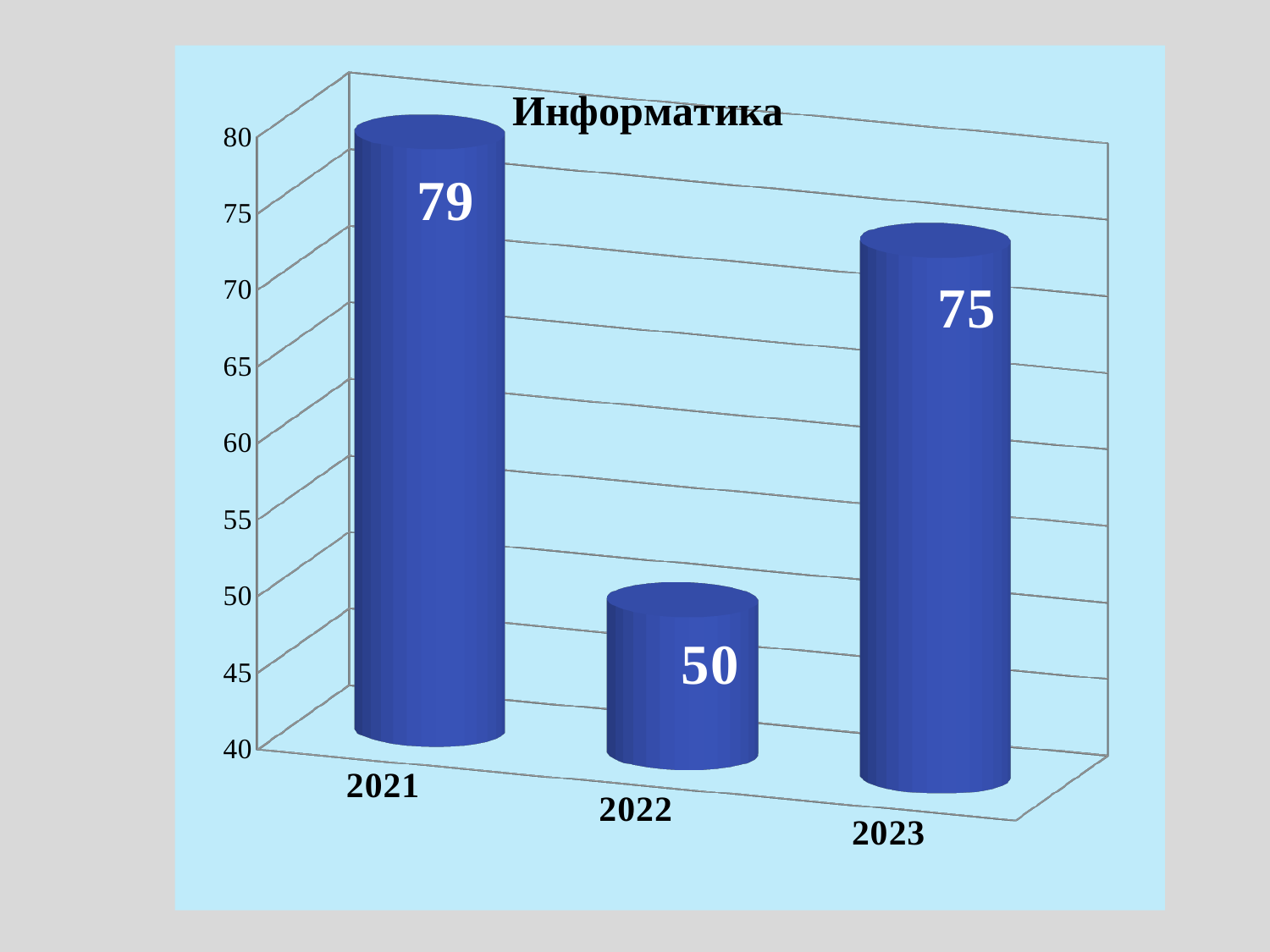
What is the title of the chart? Информатика Is the value for 2022 greater or less than 60? less What kind of chart is shown on the slide? bar chart What is the value for 2023? 75 What is the difference between the values for 2021 and 2022? 29 Which year has the lowest value? 2022 What is the value for 2021? 79 Which year has the highest value? 2021 What is the difference between the values for 2021 and 2023? 4 Which is larger, the value for 2022 or the value for 2023? 2023 How many years are shown on the chart? 3 What is the value for 2022? 50